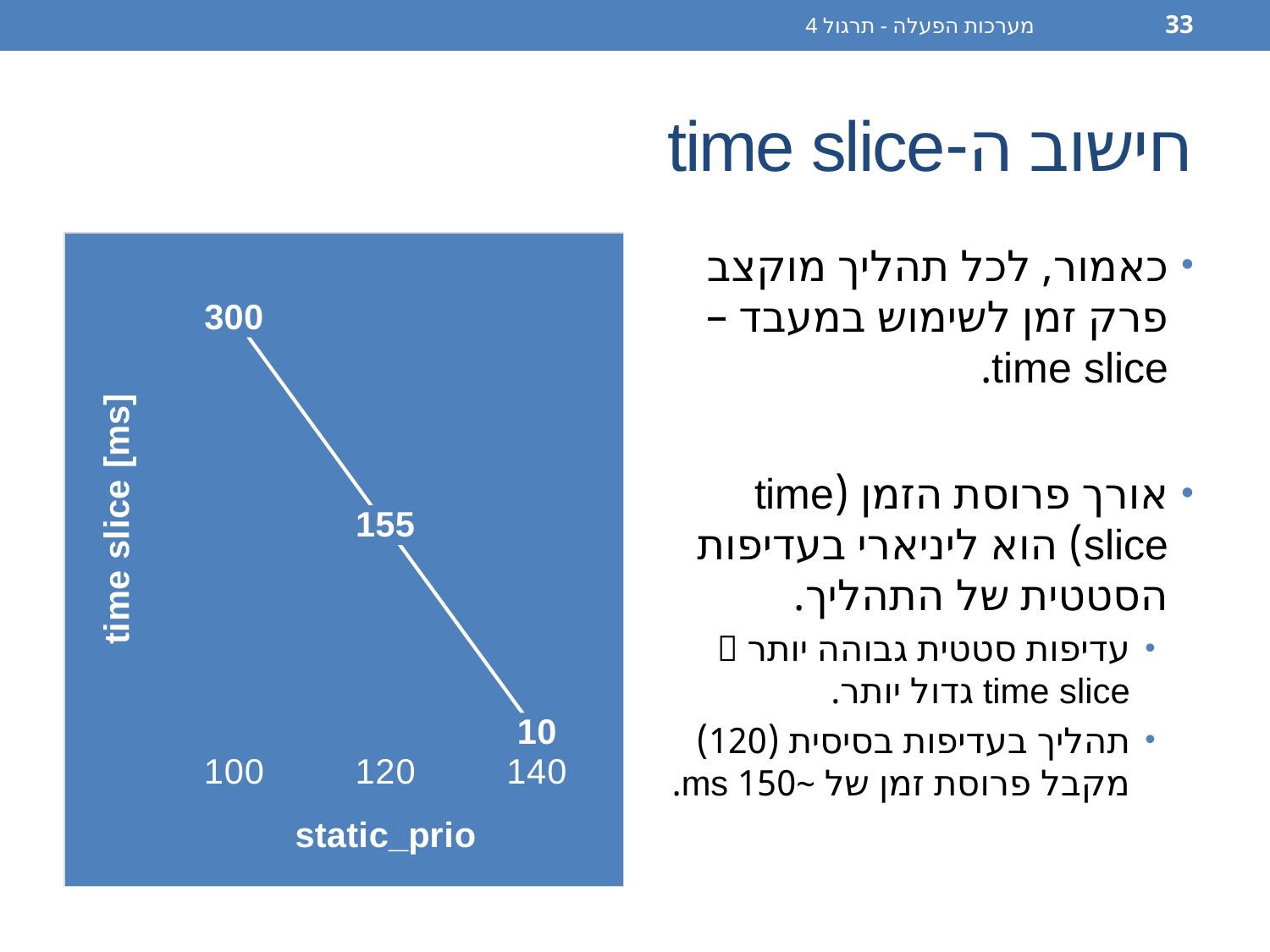
Does the time slice rise or fall as static_prio increases? fall Which has a larger time slice: static_prio 120 or static_prio 140? static_prio 120 What is the time slice value at static_prio 120? 155 What is the difference between the time slice at static_prio 100 and at static_prio 140? 290 At which static_prio value is the time slice highest? 100 What is the time slice value at static_prio 140? 10 At which static_prio value is the time slice lowest? 140 How many data points are plotted on the chart? 3 What is the time slice value at static_prio 100? 300 What is the difference between the time slice at static_prio 100 and at static_prio 120? 145 What kind of chart is shown on the slide? line chart What is the label of the vertical axis of the chart? time slice [ms]